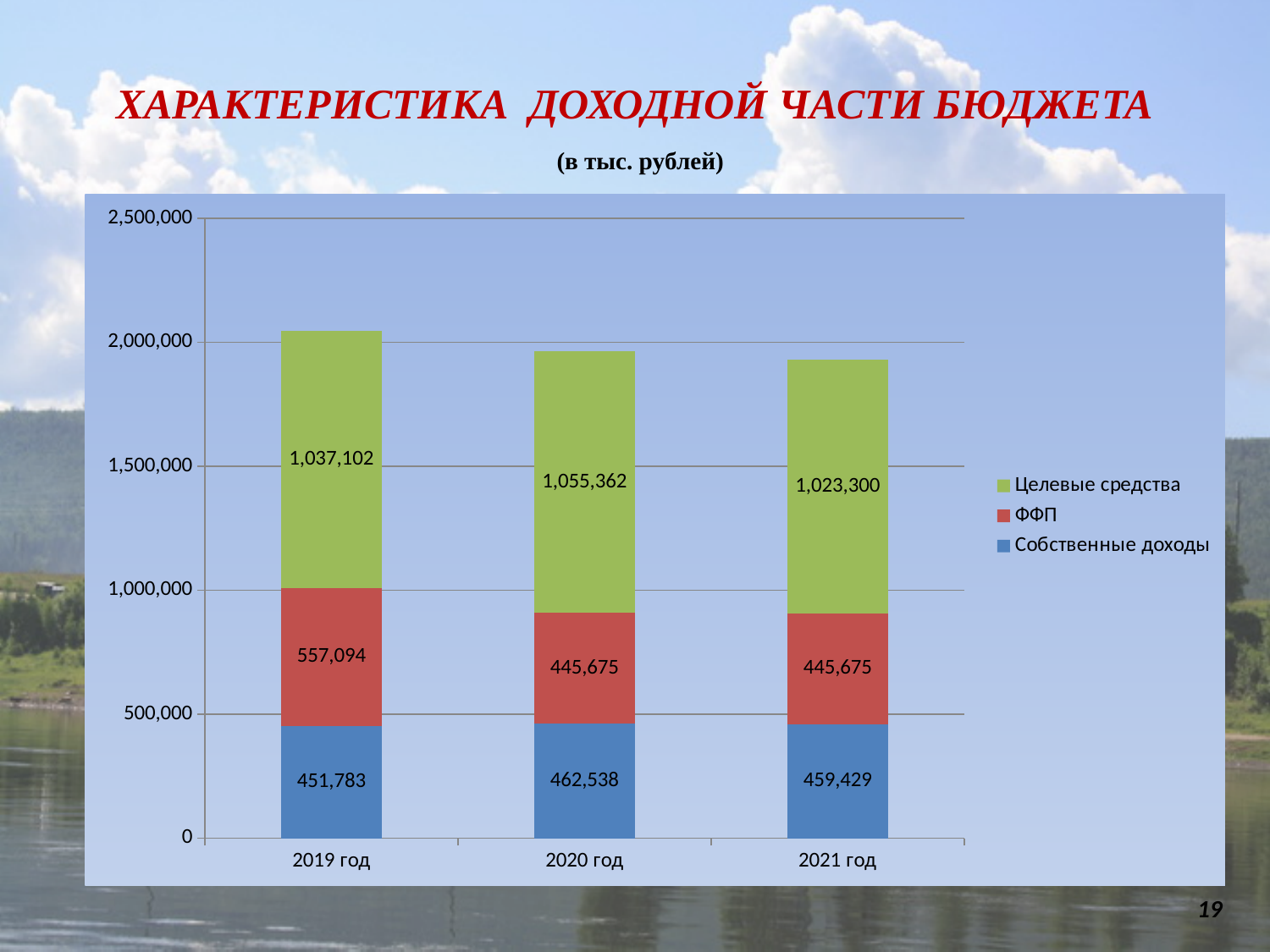
What is the total of the stacked bar for 2021 год? 1,928,404 How many series does the legend list? 3 Which is larger: ФФП in 2019 год or ФФП in 2021 год? 2019 год What kind of chart is shown on the slide? Stacked bar chart How many years are shown on the x axis? 3 What is the value of Собственные доходы for 2021 год? 459,429 What is the value of ФФП for 2020 год? 445,675 What is the total of the stacked bar for 2019 год? 2,045,979 In which year is Собственные доходы the lowest? 2019 год In which year is Целевые средства the highest? 2020 год What is the difference between ФФП in 2019 год and ФФП in 2020 год? 111,419 What is the value of Целевые средства for 2019 год? 1,037,102